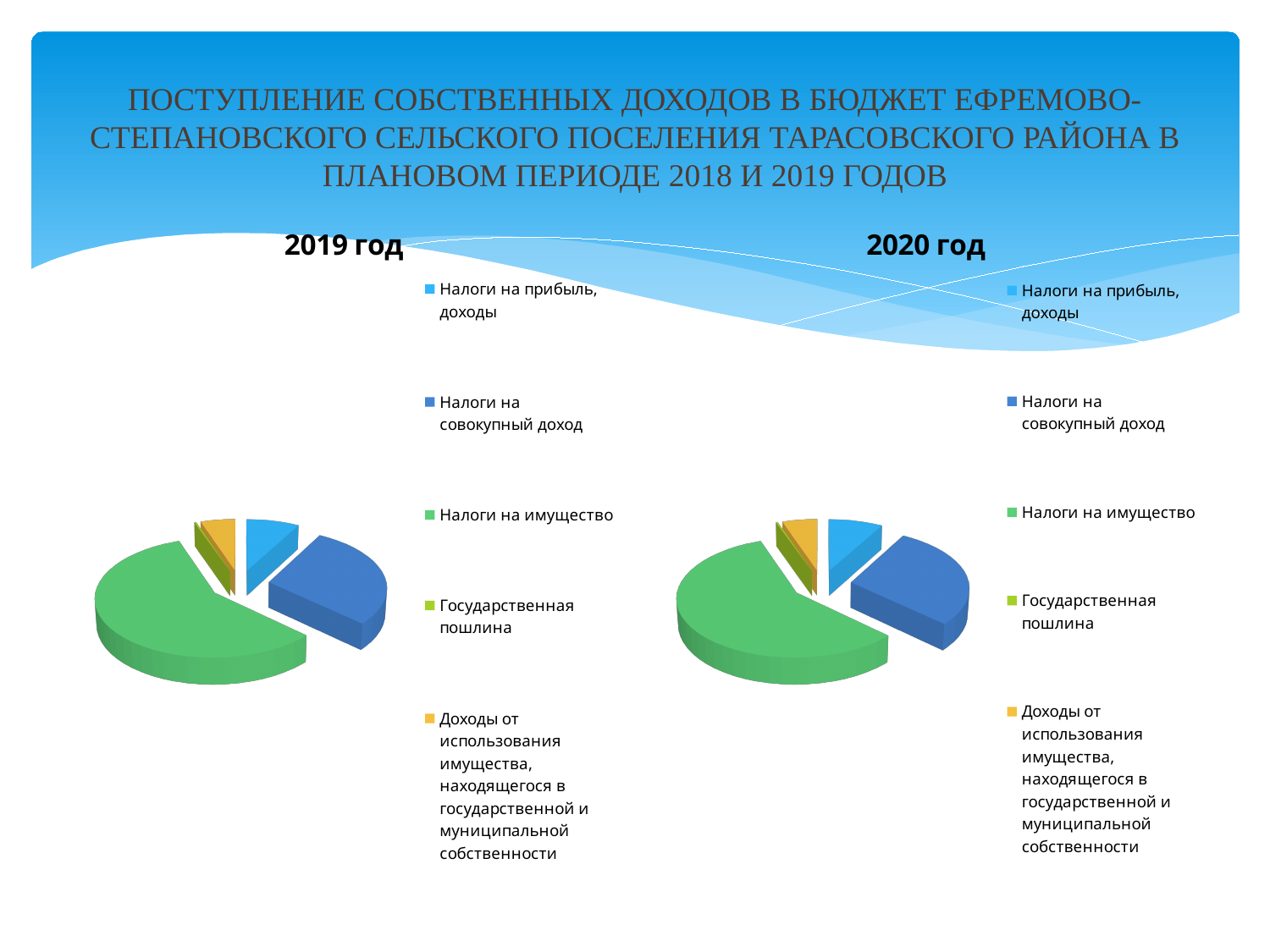
In the "2019 год" chart, which category has the largest slice? Налоги на имущество How many categories does the legend of the "2020 год" chart list? 5 In the "2020 год" chart, which slice is larger: "Налоги на имущество" or "Налоги на совокупный доход"? Налоги на имущество What kind of chart is the "2019 год" chart? pie chart How many categories does the legend of the "2019 год" chart list? 5 In the "2020 год" chart, which slice is larger: "Налоги на прибыль, доходы" or "Государственная пошлина"? Налоги на прибыль, доходы In the "2019 год" chart, which slice is larger: "Налоги на совокупный доход" or "Налоги на прибыль, доходы"? Налоги на совокупный доход In the "2019 год" chart, what colour represents "Налоги на имущество"? green What kind of chart is the "2020 год" chart? pie chart In the "2020 год" chart, which category has the largest slice? Налоги на имущество How many pie charts are shown on the slide? 2